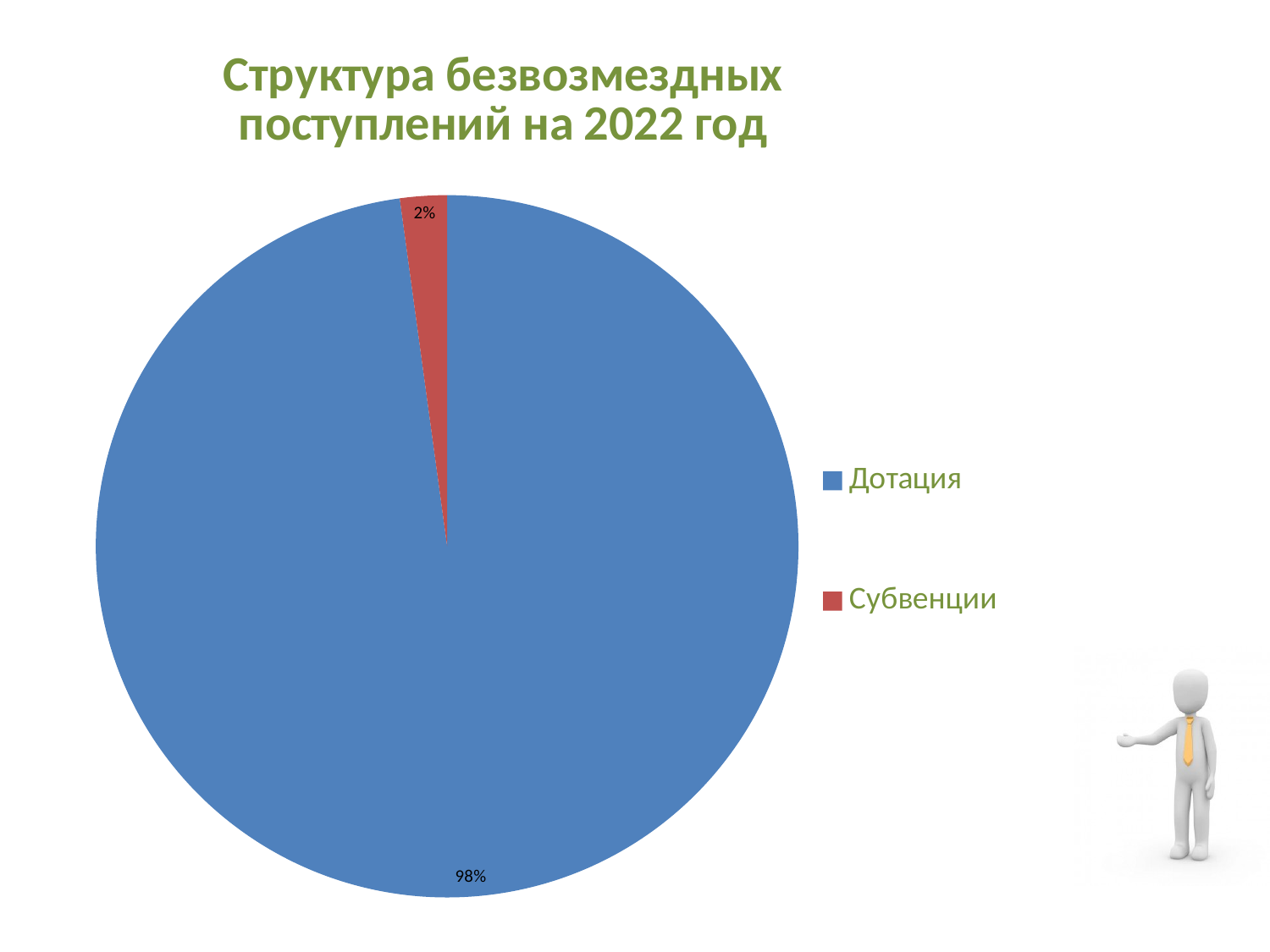
What is the title of the chart? Структура безвозмездных поступлений на 2022 год What is the difference in percentage points between the Дотация and Субвенции slices? 96 What kind of chart is shown on the slide? pie chart What colour is the Субвенции slice? red Which category has the smallest slice of the pie? Субвенции How many slices does the pie chart have? 2 What share of the pie does Дотация account for? 98% How many entries does the legend list? 2 Which is larger, the Дотация slice or the Субвенции slice? Дотация Which category has the largest slice of the pie? Дотация What share of the pie does Субвенции account for? 2%